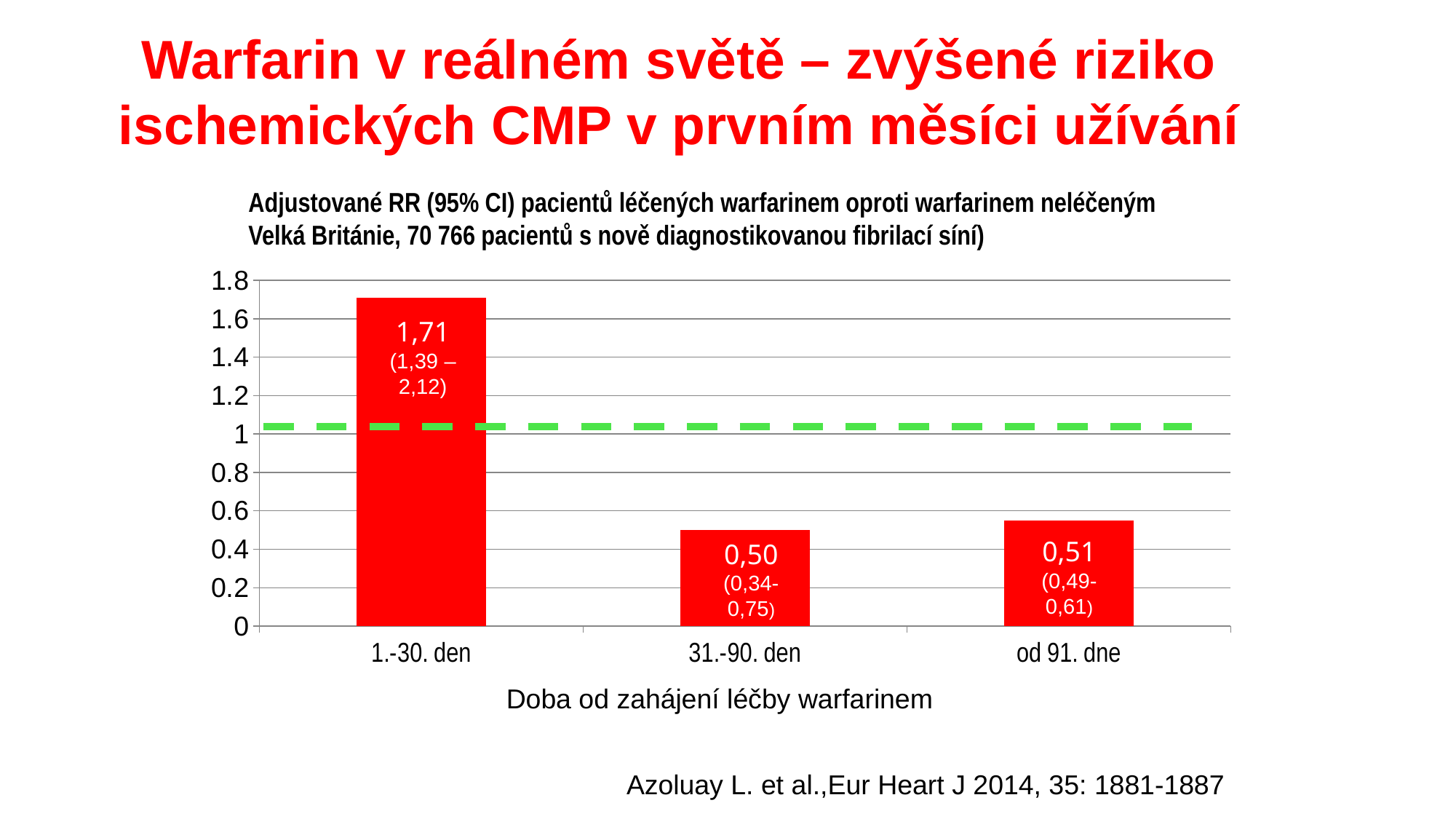
What kind of chart is shown on the slide? bar chart What is the adjusted RR value shown for the category "1.-30. den"? 1,71 What is the 95% confidence interval printed on the bar for "1.-30. den"? (1,39 – 2,12) What is the value shown for the category "od 91. dne"? 0,51 Is the value for "31.-90. den" greater or less than 1? less Which category has the highest value in the chart? 1.-30. den What is the value shown for the category "31.-90. den"? 0,50 What is the difference between the values for "1.-30. den" and "31.-90. den"? 1,21 Is the value for "1.-30. den" greater or less than 1? greater Which is larger, the value for "1.-30. den" or the value for "od 91. dne"? 1.-30. den How many categories are shown on the x axis of the chart? 3 What is the difference between the values for "1.-30. den" and "od 91. dne"? 1,20